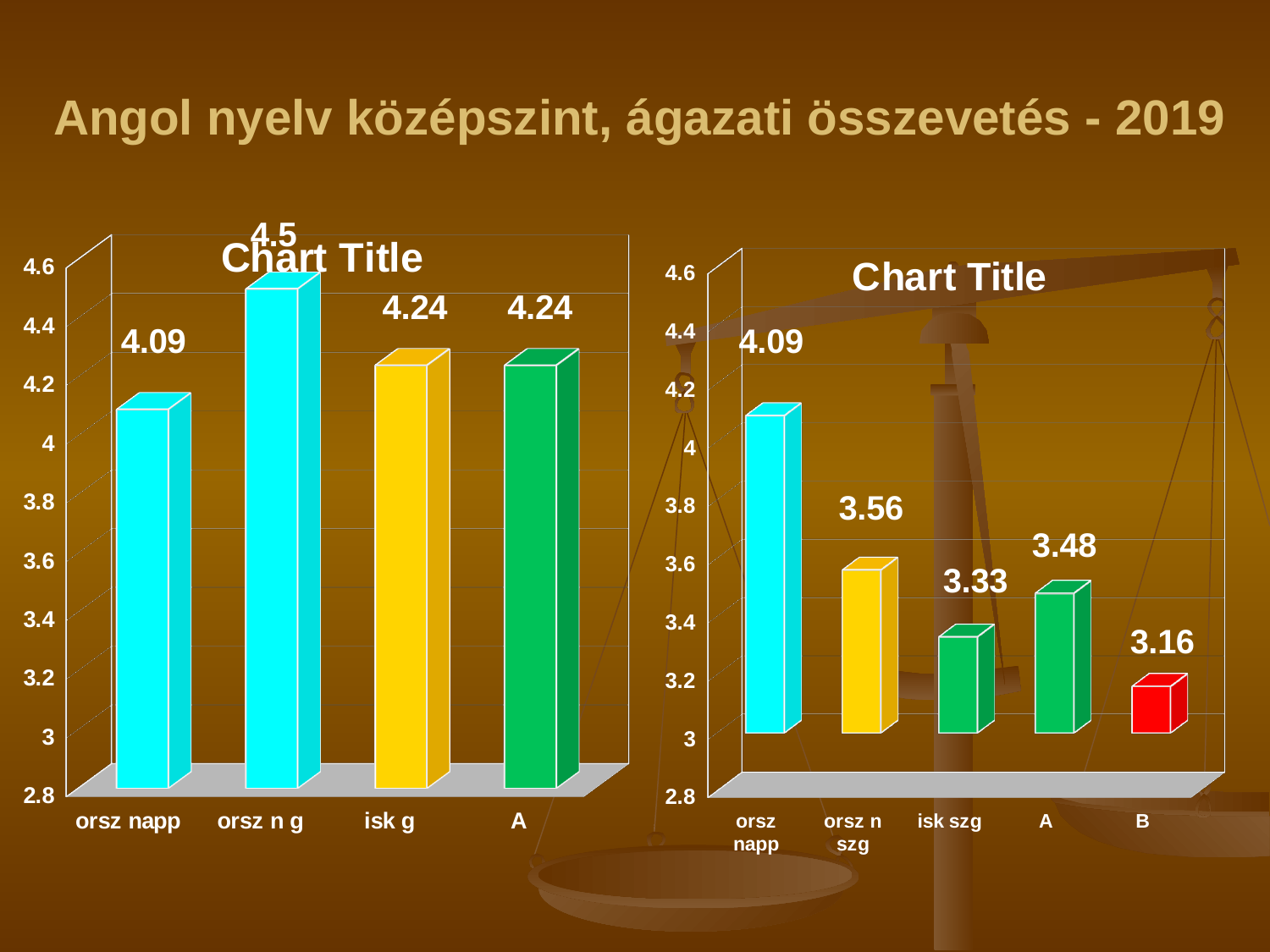
In the right chart, which category has the lowest value? B In the left chart, what is the value for orsz n g? 4.5 What kind of chart is the right chart? bar chart How many categories are shown in the left chart? 4 In the right chart, what is the value for B? 3.16 In the left chart, which category has the lowest value? orsz napp In the right chart, what is the difference between the values for orsz napp and B? 0.93 In the right chart, what is the value for isk szg? 3.33 In the right chart, which is larger, the value for orsz n szg or the value for A? orsz n szg In the left chart, what is the value for isk g? 4.24 In the left chart, what is the difference between the values for orsz n g and orsz napp? 0.41 In the right chart, which category has the highest value? orsz napp